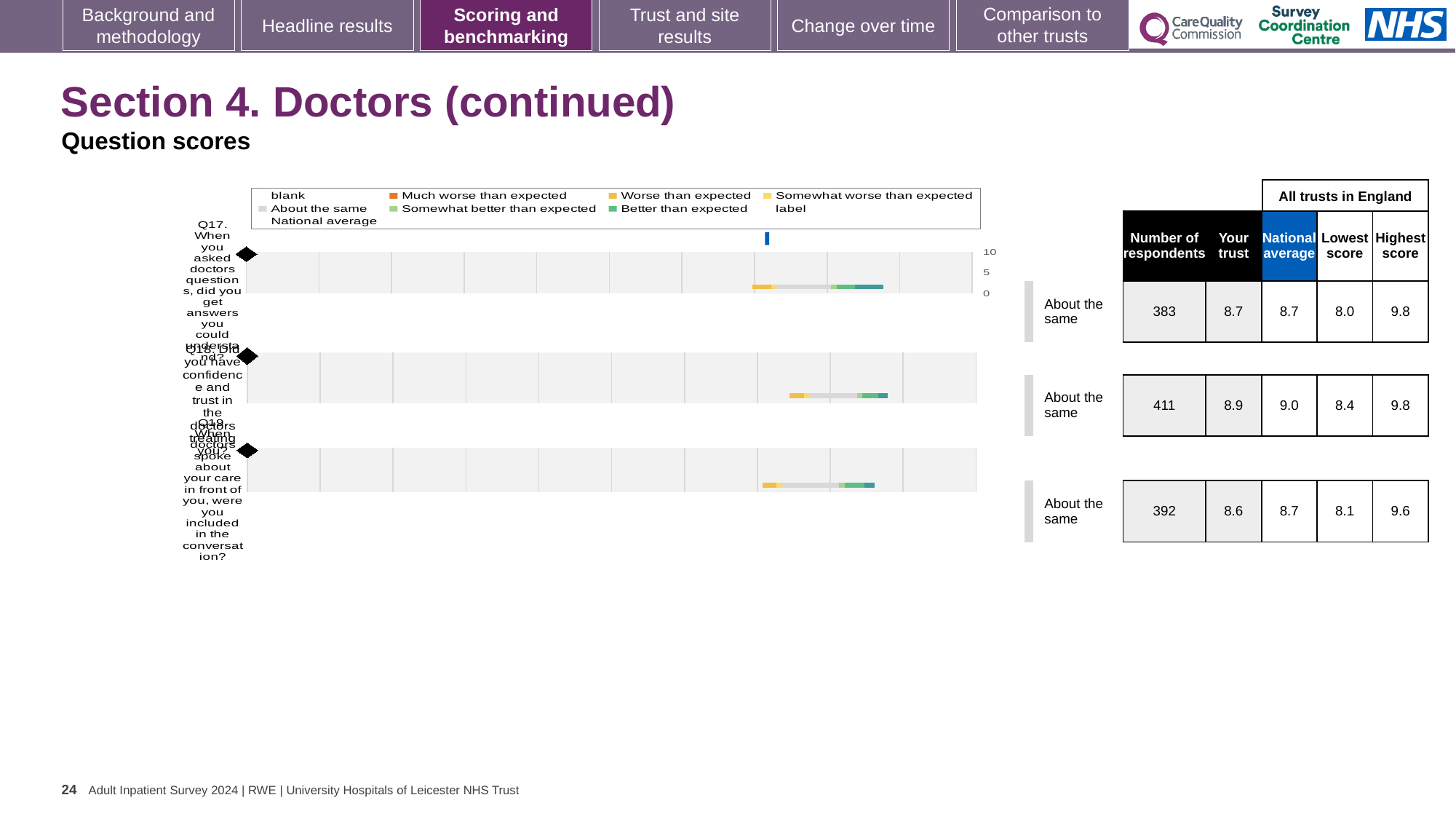
What is the highest score across all trusts in England for Q19? 9.6 What benchmark category is shown for all three questions on the slide? About the same For Q18, which is larger: the 'Your trust' score or the national average? National average What kind of chart is shown on the slide? bar chart How many questions (categories) are plotted in the chart? 3 What is the national average score for Q19 (When doctors spoke about your care in front of you, were you included in the conversation)? 8.7 How many respondents answered Q18? 411 What is the difference between the 'Your trust' scores for Q18 and Q17? 0.2 What is the 'Your trust' score for Q17 (When you asked doctors questions, did you get answers you could understand)? 8.7 What is the 'Your trust' score for Q18 (Did you have confidence and trust in the doctors treating you)? 8.9 Which question has the lowest 'Your trust' score? Q19 Which question has the highest 'Your trust' score? Q18